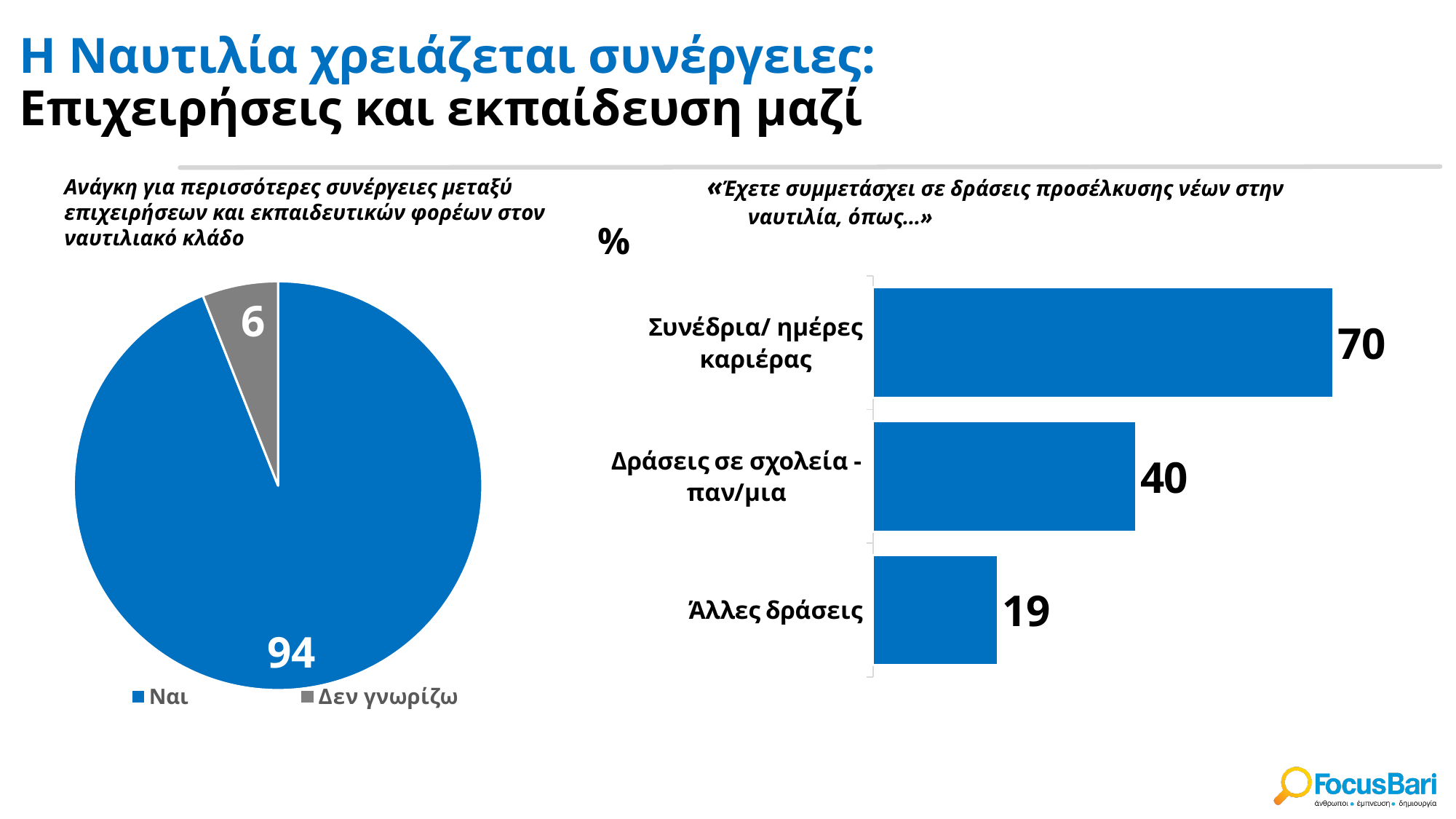
What kind of chart is the chart on the right? bar chart In the bar chart on the right, which category has the lowest value? Άλλες δράσεις In the pie chart on the left, which slice is the largest? Ναι What kind of chart is the chart on the left? pie chart In the bar chart on the right, what is the value for Συνέδρια/ ημέρες καριέρας? 70 In the pie chart on the left, what is the difference between Ναι and Δεν γνωρίζω? 88 In the bar chart on the right, how many categories are shown? 3 In the bar chart on the right, what is the difference between Συνέδρια/ ημέρες καριέρας and Άλλες δράσεις? 51 In the pie chart on the left, what is the value for Δεν γνωρίζω? 6 In the pie chart on the left, what is the value for Ναι? 94 In the pie chart on the left, how many slices are there? 2 In the bar chart on the right, what is the value for Δράσεις σε σχολεία - παν/μια? 40